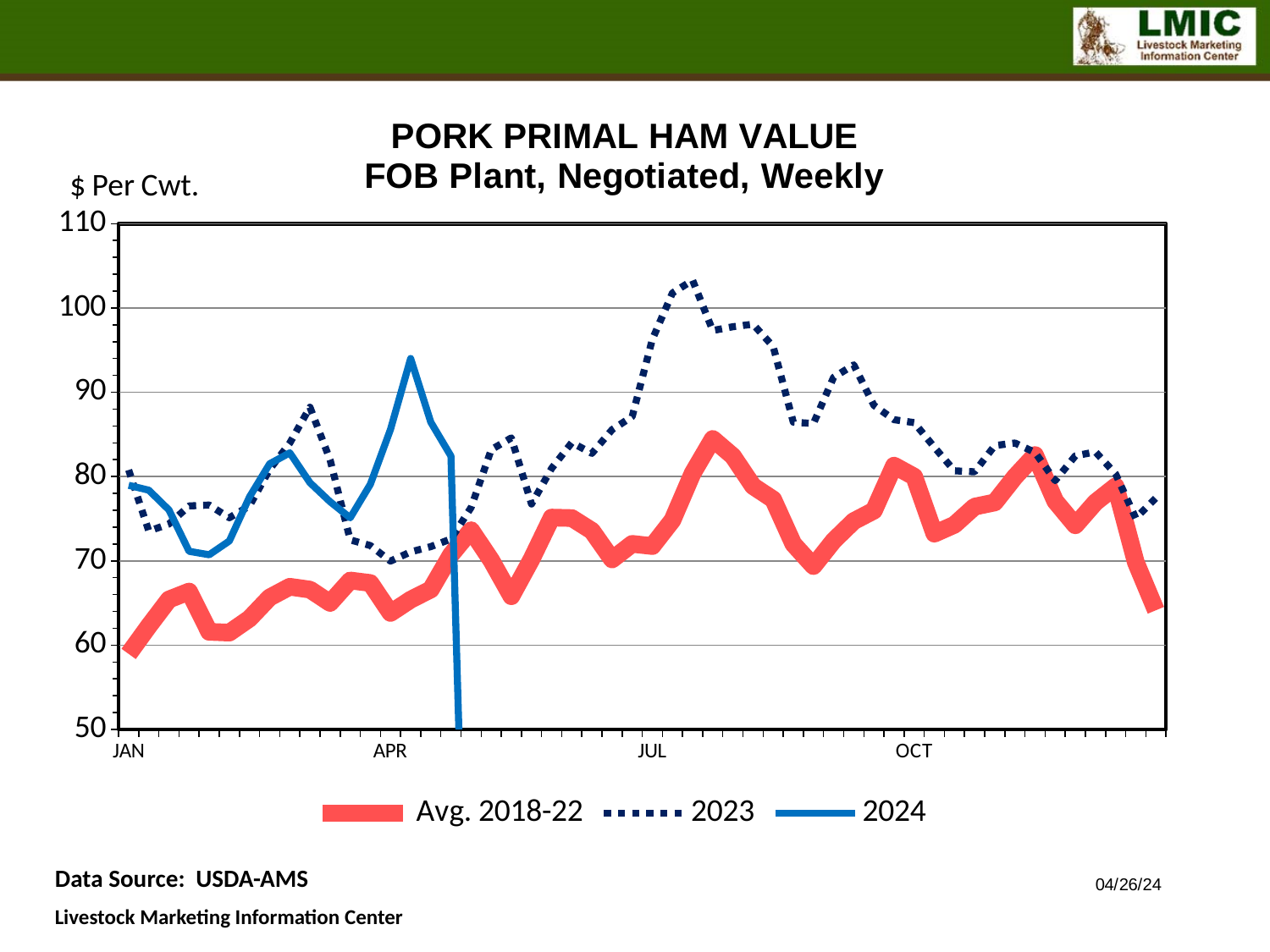
In April, which series is higher, 2024 or 2023? 2024 Is the peak value of the 2023 series in early August greater or less than 100? greater Which series reaches the highest value on the chart? 2023 Is the value of the Avg. 2018-22 series at the end of December greater or less than 70? less Is the peak value of the 2024 series in April greater or less than 90? greater In early August, which series is higher, 2023 or Avg. 2018-22? 2023 What kind of chart is shown on the slide? line chart Does the Avg. 2018-22 series rise or fall from JAN to APR? rise What unit is shown on the y axis of the chart? $ Per Cwt. What is the title of the chart? PORK PRIMAL HAM VALUE FOB Plant, Negotiated, Weekly How many series does the legend list? 3